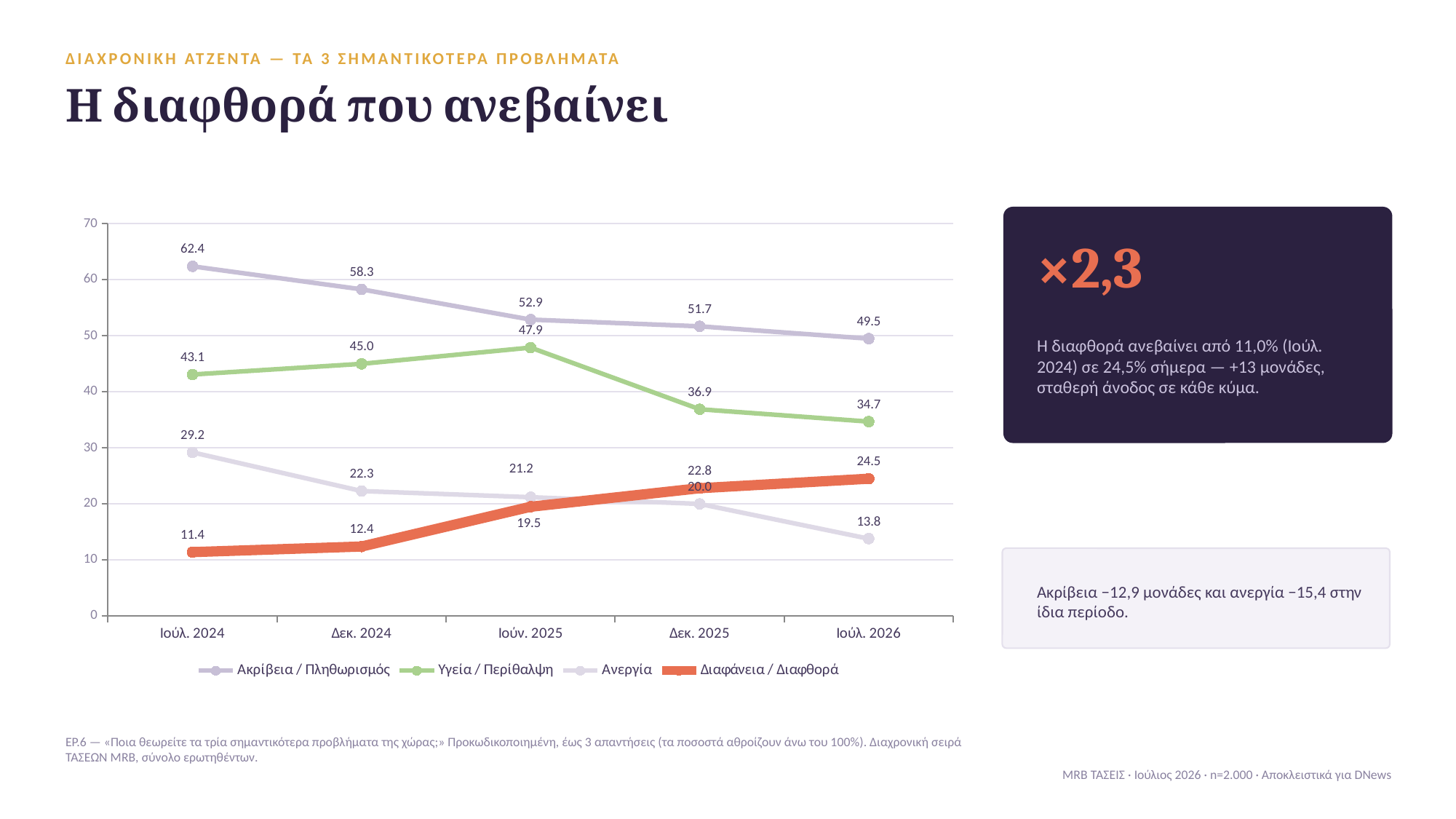
Which is larger at Δεκ. 2025: Ανεργία or Διαφάνεια / Διαφθορά? Διαφάνεια / Διαφθορά At which time point is the Ανεργία series lowest? Ιούλ. 2026 At which time point is the Υγεία / Περίθαλψη series highest? Ιούν. 2025 What kind of chart is shown on the slide? Line chart What is the value for Ανεργία at Δεκ. 2025? 20.0 Does the Διαφάνεια / Διαφθορά series rise or fall from Ιούλ. 2024 to Ιούλ. 2026? Rise How many time points are shown on the x axis? 5 What is the value for Διαφάνεια / Διαφθορά at Ιούλ. 2026? 24.5 What is the value for Ακρίβεια / Πληθωρισμός at Ιούλ. 2024? 62.4 How many series does the legend list? 4 What is the difference between the Ακρίβεια / Πληθωρισμός values at Ιούλ. 2024 and Ιούλ. 2026? 12.9 What is the value for Υγεία / Περίθαλψη at Ιούν. 2025? 47.9